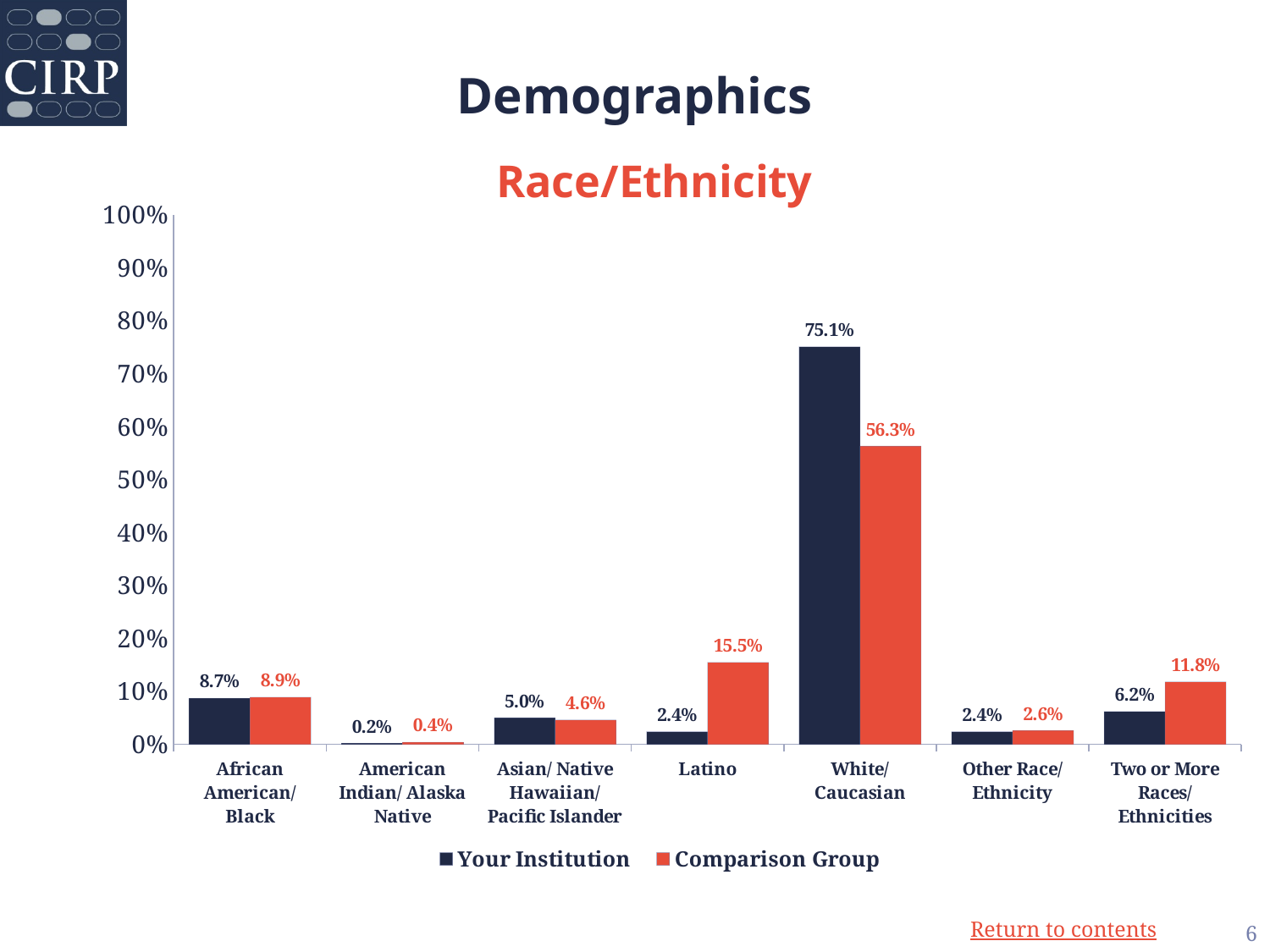
What is the difference between the Your Institution and Comparison Group values for White/Caucasian? 18.8% How many series does the legend list? 2 Which category has the highest Comparison Group value? White/Caucasian What kind of chart is shown on the slide? bar chart Is the Your Institution value for White/Caucasian greater or less than 70%? greater What is the Your Institution value for White/Caucasian? 75.1% For Latino, which series has the larger value, Your Institution or Comparison Group? Comparison Group What is the difference between the Comparison Group and Your Institution values for Two or More Races/Ethnicities? 5.6% Which category has the lowest Your Institution value? American Indian/Alaska Native What is the Your Institution value for Two or More Races/Ethnicities? 6.2% What is the Comparison Group value for Latino? 15.5% How many race/ethnicity categories are shown on the x axis? 7